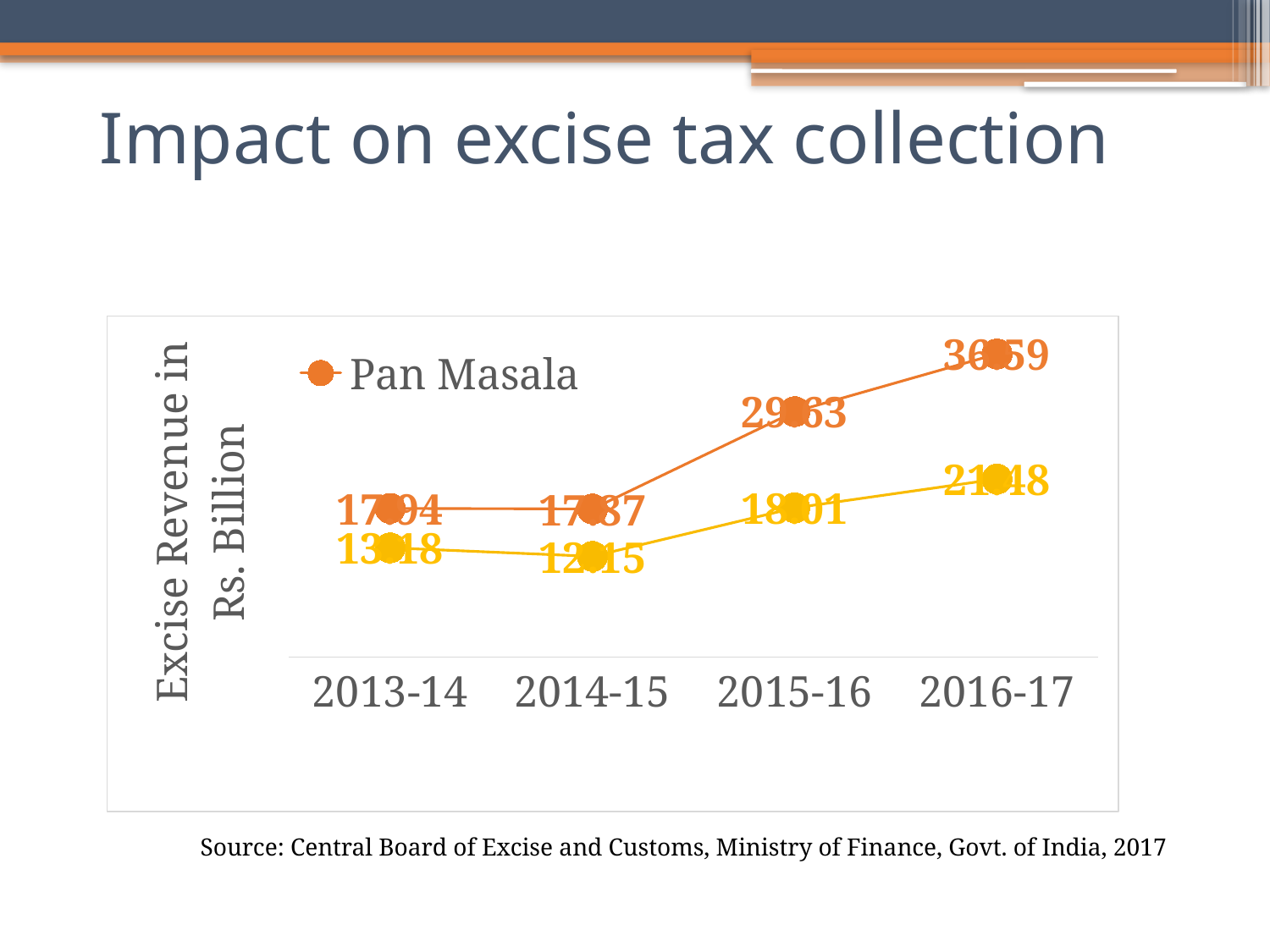
How many lines are plotted on the chart? 2 What is the first fiscal year shown on the x axis? 2013-14 Does the Pan Masala excise revenue rise or fall between 2014-15 and 2016-17? Rise How many fiscal years are shown on the x axis? 4 In which year is the yellow (lower) line at its highest value? 2016-17 Which series is named in the chart legend? Pan Masala What is the label on the vertical axis of the chart? Excise Revenue in Rs. Billion What kind of chart is shown on the slide? Line chart In which year is the Pan Masala excise revenue highest? 2016-17 In 2015-16, which line is higher: the Pan Masala line or the yellow line? Pan Masala How many series does the chart legend list? 1 In which year is the yellow (lower) line at its lowest value? 2014-15